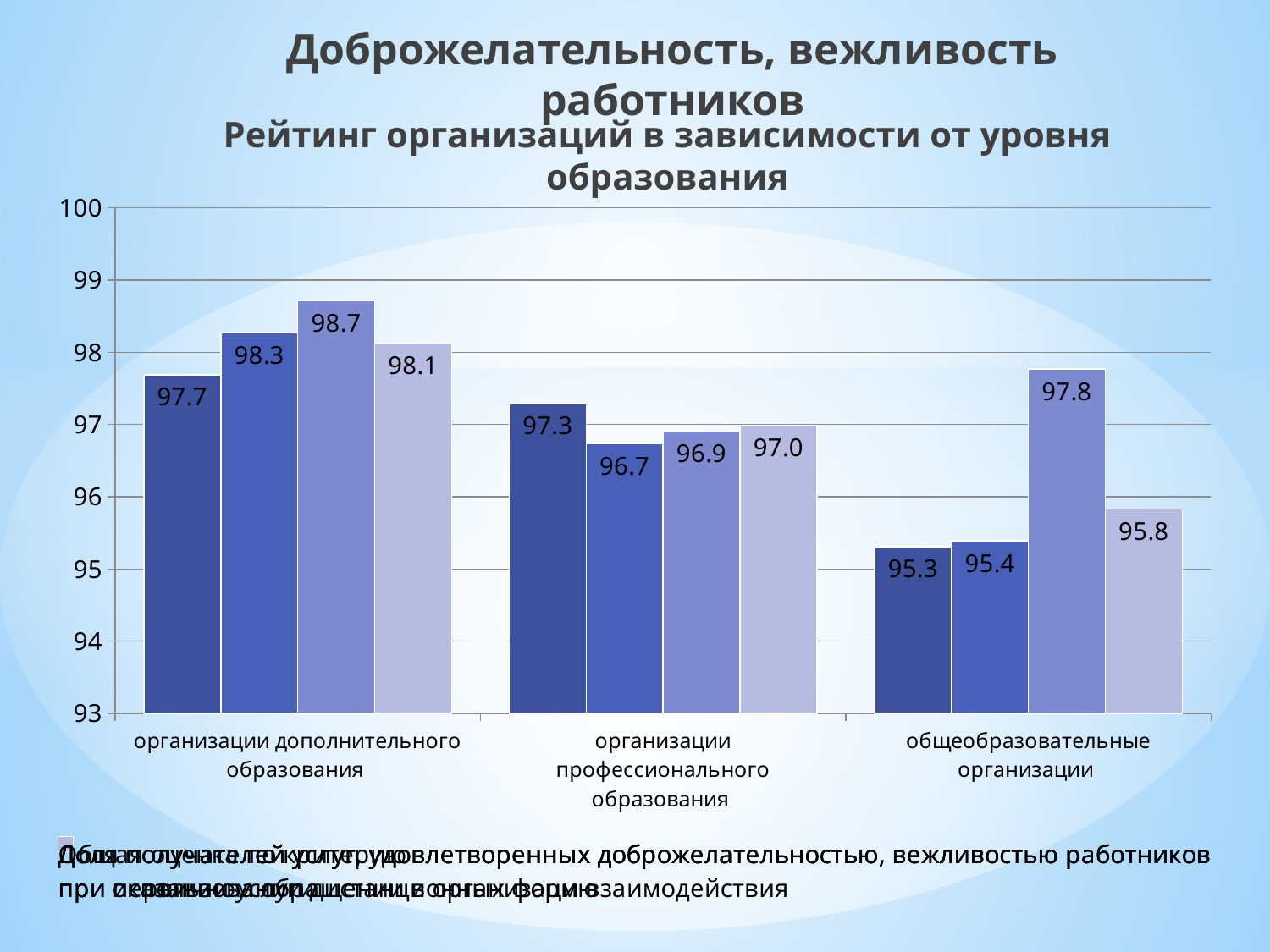
Which bar in the 'общеобразовательные организации' group has the highest value? the third bar (97.8) What type of chart is shown on the slide? bar chart What is the title of the chart? Рейтинг организаций в зависимости от уровня образования Is the value of the first bar in the 'общеобразовательные организации' group greater or less than 96? less How many categories are shown on the x axis of the chart? 3 Which is larger: the first bar in 'организации профессионального образования' (97.3) or the third bar in 'общеобразовательные организации' (97.8)? the third bar in 'общеобразовательные организации' (97.8) What is the value of the second bar in the 'организации профессионального образования' group? 96.7 What is the difference between the highest and lowest values in the 'организации дополнительного образования' group? 1.0 Which bar in the 'организации профессионального образования' group has the lowest value? the second bar (96.7) What is the value of the fourth (rightmost) bar in the 'общеобразовательные организации' group? 95.8 What is the value of the first (leftmost) bar in the 'организации дополнительного образования' group? 97.7 What is the value of the third bar in the 'организации дополнительного образования' group? 98.7